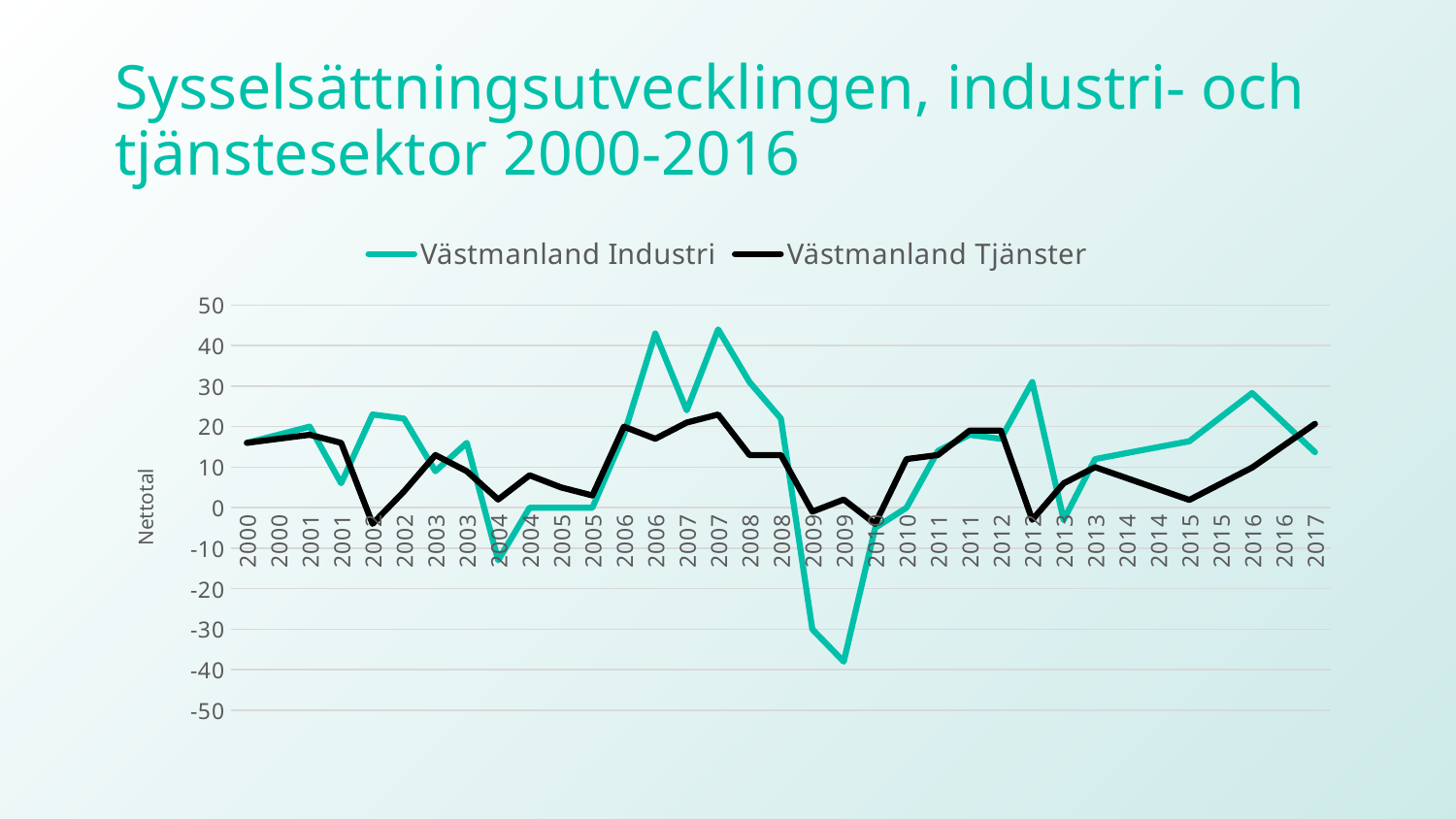
What is the title of the chart? Sysselsättningsutvecklingen, industri- och tjänstesektor 2000-2016 Does Västmanland Industri rise or fall from the second 2009 point to the second 2010 point? rise Is the value for Västmanland Industri at the first 2007 point greater or less than 40? less At the first 2007 point, which series has the higher value, Västmanland Industri or Västmanland Tjänster? Västmanland Industri What kind of chart is shown on the slide? line chart Is the value for Västmanland Tjänster at the second 2007 point greater or less than 30? less At the second 2009 point, which series has the higher value, Västmanland Industri or Västmanland Tjänster? Västmanland Tjänster Is the value for Västmanland Industri at the second 2009 point greater or less than -30? less At which point does Västmanland Industri reach its lowest value? second 2009 point How many series does the legend list? 2 What is the label on the vertical axis? Nettotal